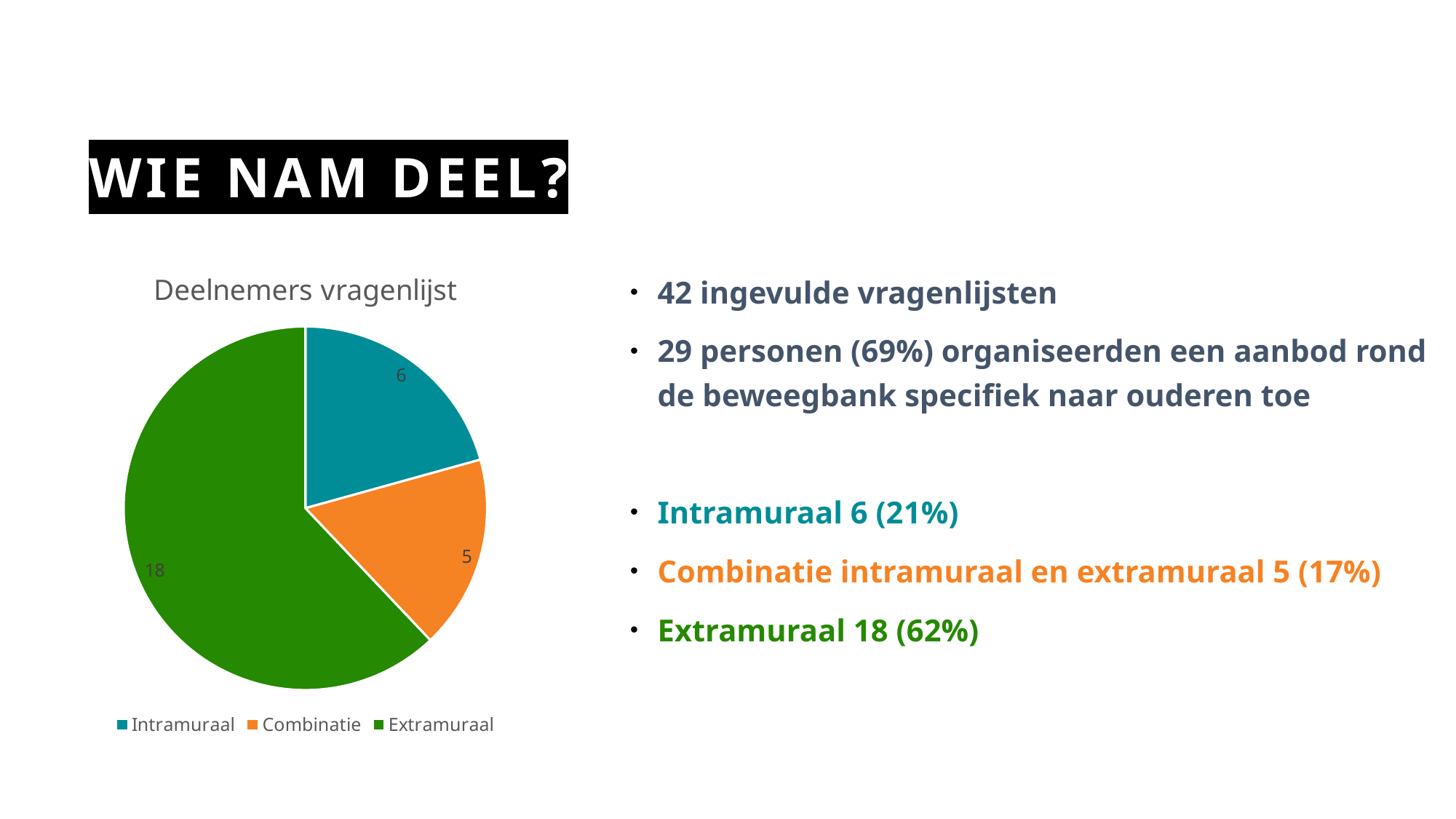
What type of chart is shown on the slide? pie chart Which category has the largest slice? Extramuraal What is the value for Combinatie? 5 How many entries does the legend list? 3 Which category has the smallest slice? Combinatie What is the total of all slices in the pie chart? 29 What is the title of the chart? Deelnemers vragenlijst What is the value for Intramuraal? 6 What is the value for Extramuraal? 18 What is the difference between the values for Extramuraal and Intramuraal? 12 Which is larger, the value for Intramuraal or the value for Combinatie? Intramuraal How many slices does the pie chart have? 3